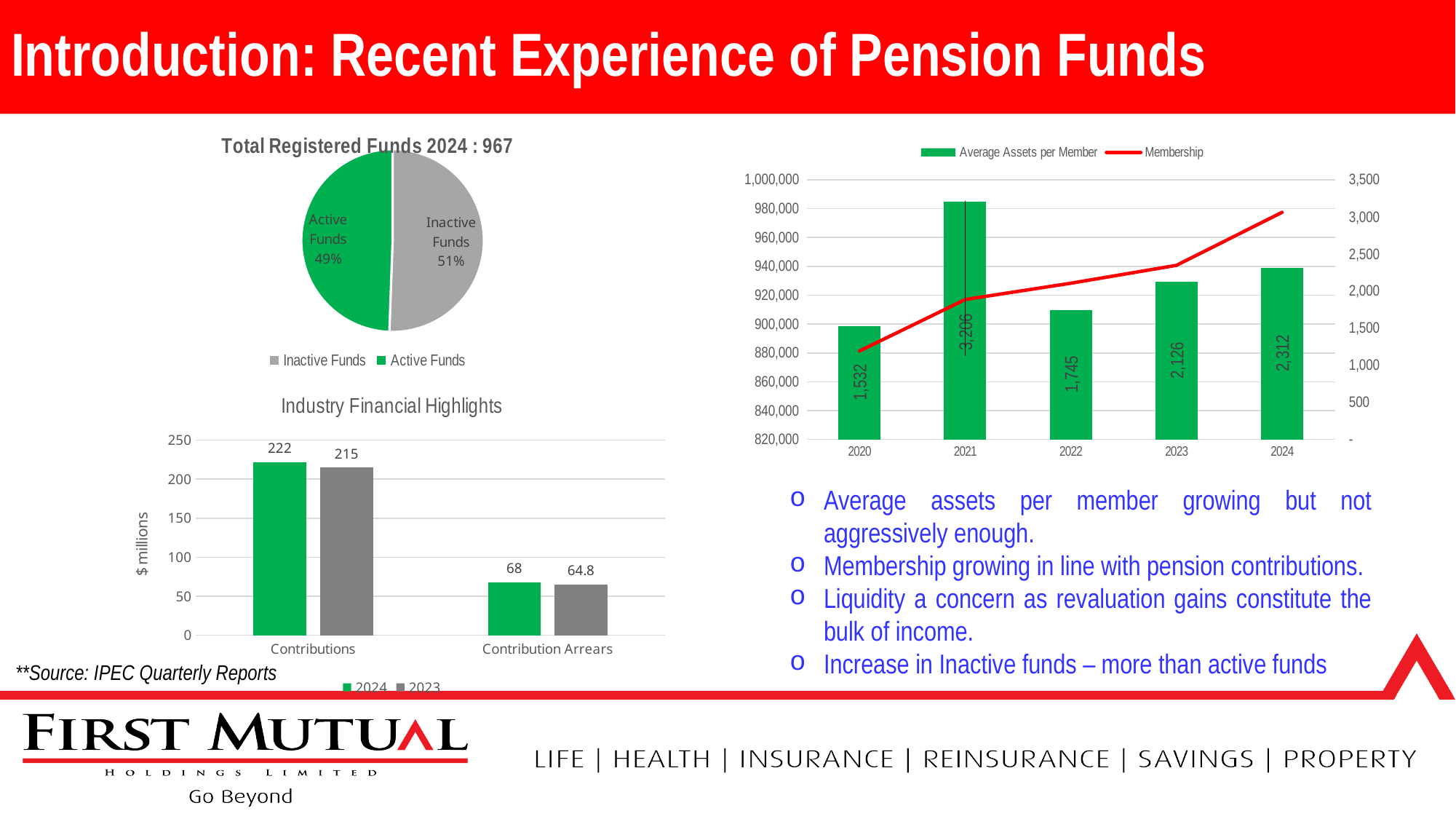
In the 'Industry Financial Highlights' chart, what unit is shown on the vertical axis? $ millions In the chart on the right with the 'Average Assets per Member' bars, which year has the tallest bar? 2021 In the pie chart 'Total Registered Funds 2024 : 967', what share is Inactive Funds? 51% In the 'Industry Financial Highlights' chart, what is the difference between Contributions in 2024 and 2023? 7 In the 'Industry Financial Highlights' chart, what is the value for Contributions in 2024? 222 In the chart on the right with the 'Average Assets per Member' bars, is the bar for 2022 greater or less than 920,000? less What kind of chart is 'Industry Financial Highlights'? Bar chart In the chart on the right, does the Membership line rise or fall from 2020 to 2024? Rises In the pie chart 'Total Registered Funds 2024 : 967', what share is Active Funds? 49% In the 'Industry Financial Highlights' chart, what is the value for Contribution Arrears in 2023? 64.8 In the 'Industry Financial Highlights' chart, how many series does the legend list? 2 In the pie chart 'Total Registered Funds 2024 : 967', which slice is larger, Active Funds or Inactive Funds? Inactive Funds